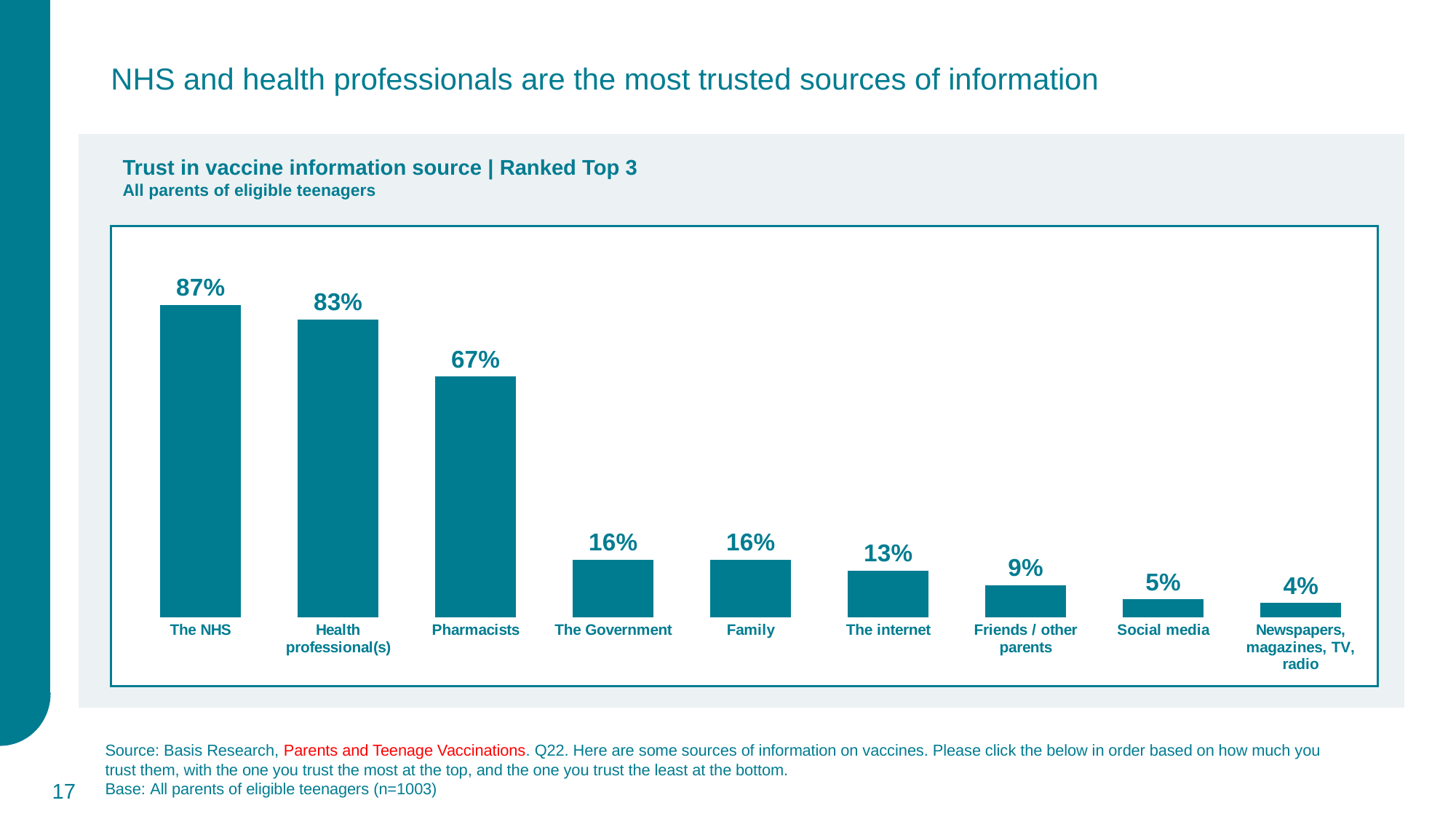
Do the values rise or fall from left to right across the chart? Fall Which information source has the lowest value? Newspapers, magazines, TV, radio What percentage of parents ranked The NHS in their top 3 trusted sources? 87% Which information source has the highest value? The NHS How many information sources are shown in the chart? 9 What type of chart is shown on the slide? Bar chart What is the value shown for Pharmacists? 67% Which has a higher value, The internet or Friends / other parents? The internet What is the value shown for Social media? 5% What is the difference between the values for Pharmacists and The Government? 51% What is the title of the chart? Trust in vaccine information source | Ranked Top 3 What is the difference between the values for The NHS and Health professional(s)? 4%